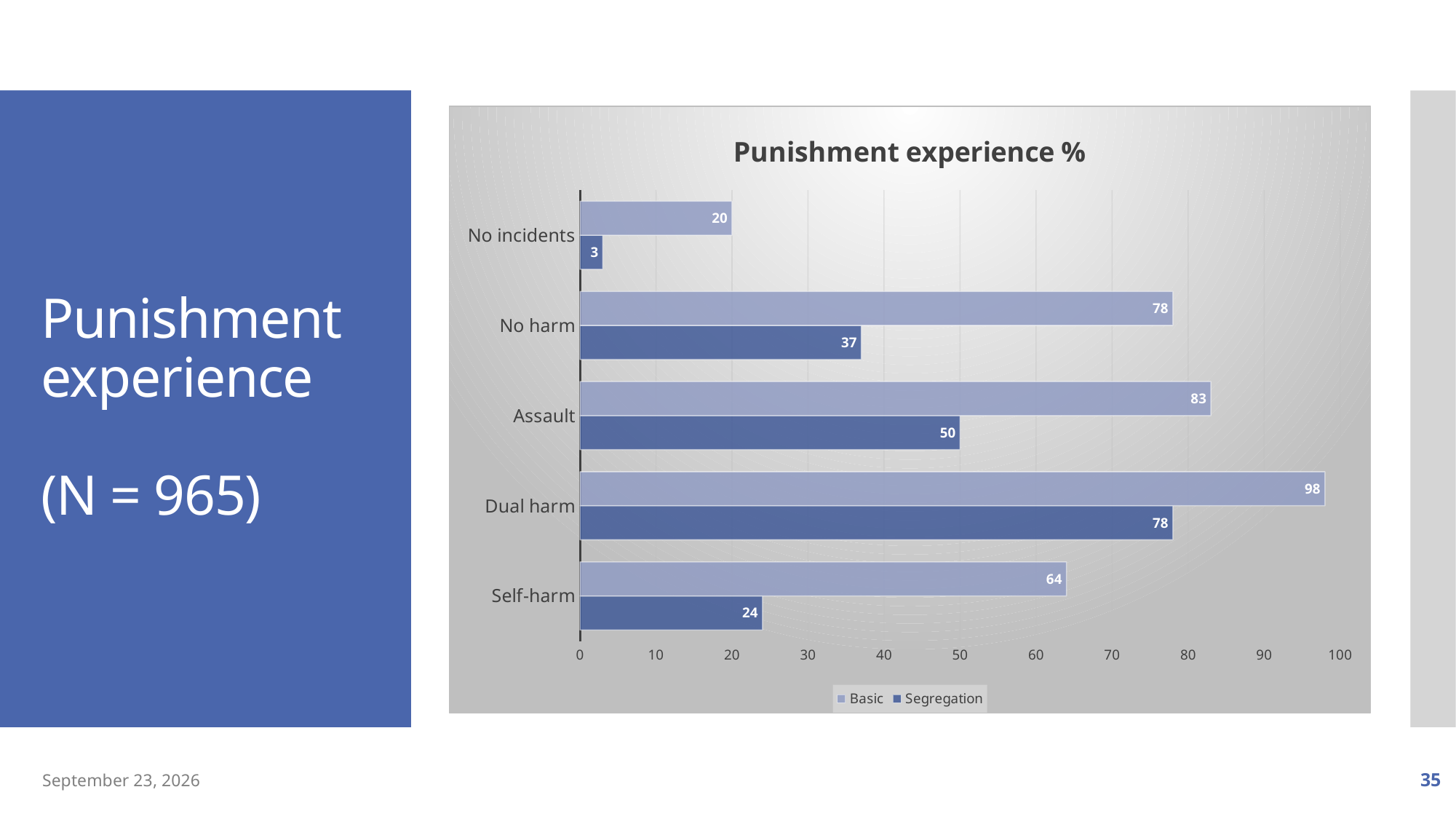
What is the Basic value for Dual harm? 98 What is the Segregation value for No incidents? 3 What kind of chart is shown on the slide? Bar chart How many series does the legend list? 2 What is the Basic value for Self-harm? 64 Which category has the highest Basic value? Dual harm How many categories are shown on the chart? 5 What is the difference between the Basic and Segregation values for No harm? 41 What is the Segregation value for Assault? 50 Which is larger, the Segregation value for Dual harm or the Basic value for Self-harm? Segregation value for Dual harm What is the title of the chart? Punishment experience % Which category has the lowest Segregation value? No incidents